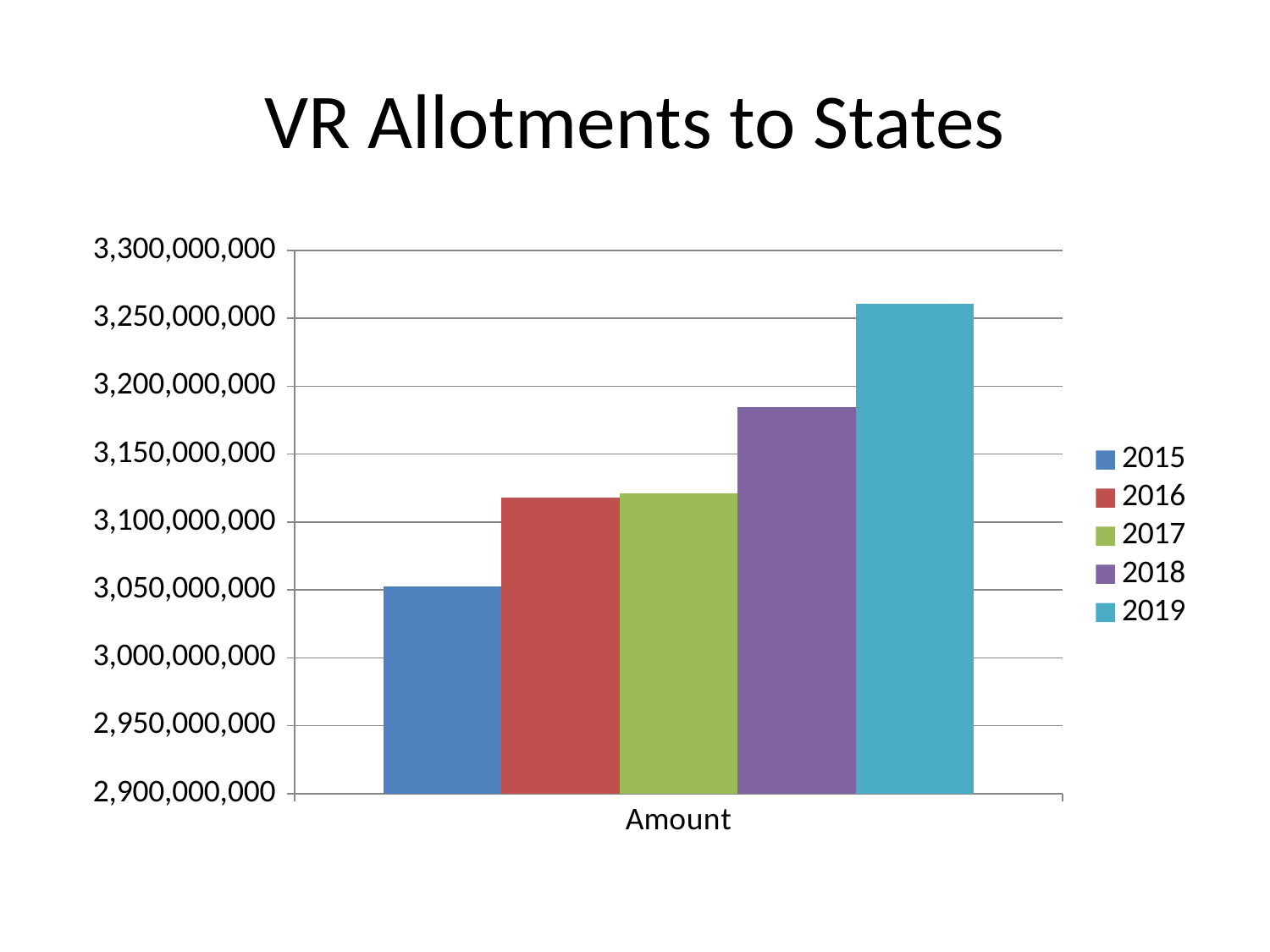
Is the value for 2019 greater or less than 3,250,000,000? greater What is the label on the x axis of the chart? Amount Is the value for 2015 greater or less than 3,100,000,000? less What kind of chart is shown on the slide? bar chart Which year has the lowest VR allotment? 2015 Which is larger, the value for 2018 or the value for 2016? 2018 Which is larger, the value for 2015 or the value for 2017? 2017 What is the title of the chart? VR Allotments to States Do the VR allotments rise or fall from 2015 to 2019? rise Which year has the highest VR allotment? 2019 Is the value for 2018 greater or less than 3,150,000,000? greater How many series does the legend list? 5